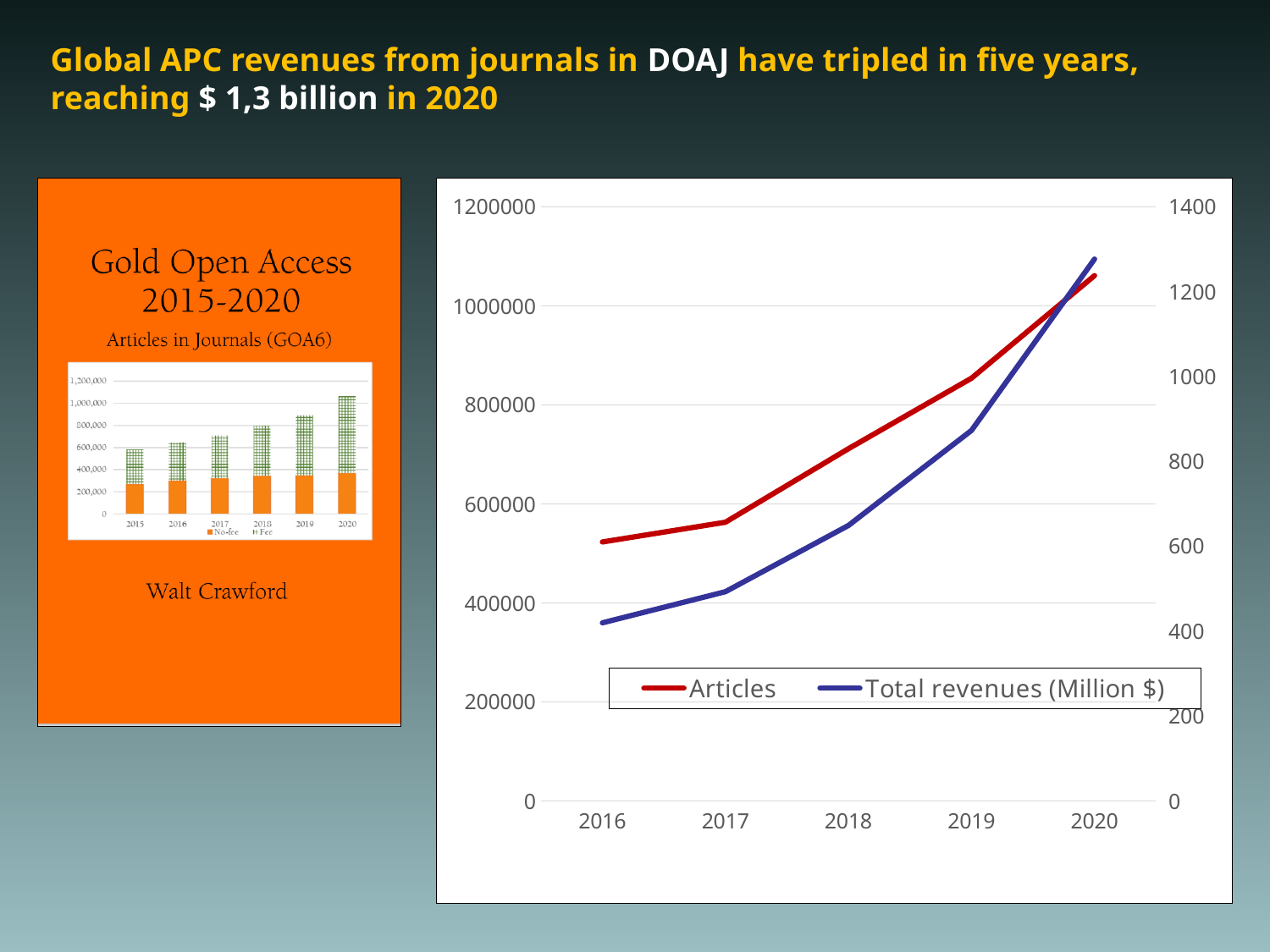
In the line chart, is the Articles value for 2018 greater or less than 800000? less In the line chart, which year has the highest Articles value? 2020 How many series does the legend of the line chart list? 2 What kind of chart is shown on the right side of the slide? line chart In the line chart, is the Total revenues (Million $) value for 2020 greater or less than 1200? greater In the line chart, what colour is the line for Total revenues (Million $)? blue In the line chart, do the Total revenues (Million $) values rise or fall from 2016 to 2020? rise How many years are plotted along the x axis of the line chart? 5 In the line chart, is the Articles value for 2016 greater or less than 600000? less In the line chart, do the Articles values rise or fall from 2016 to 2020? rise In the line chart, which year has the lowest Total revenues (Million $) value? 2016